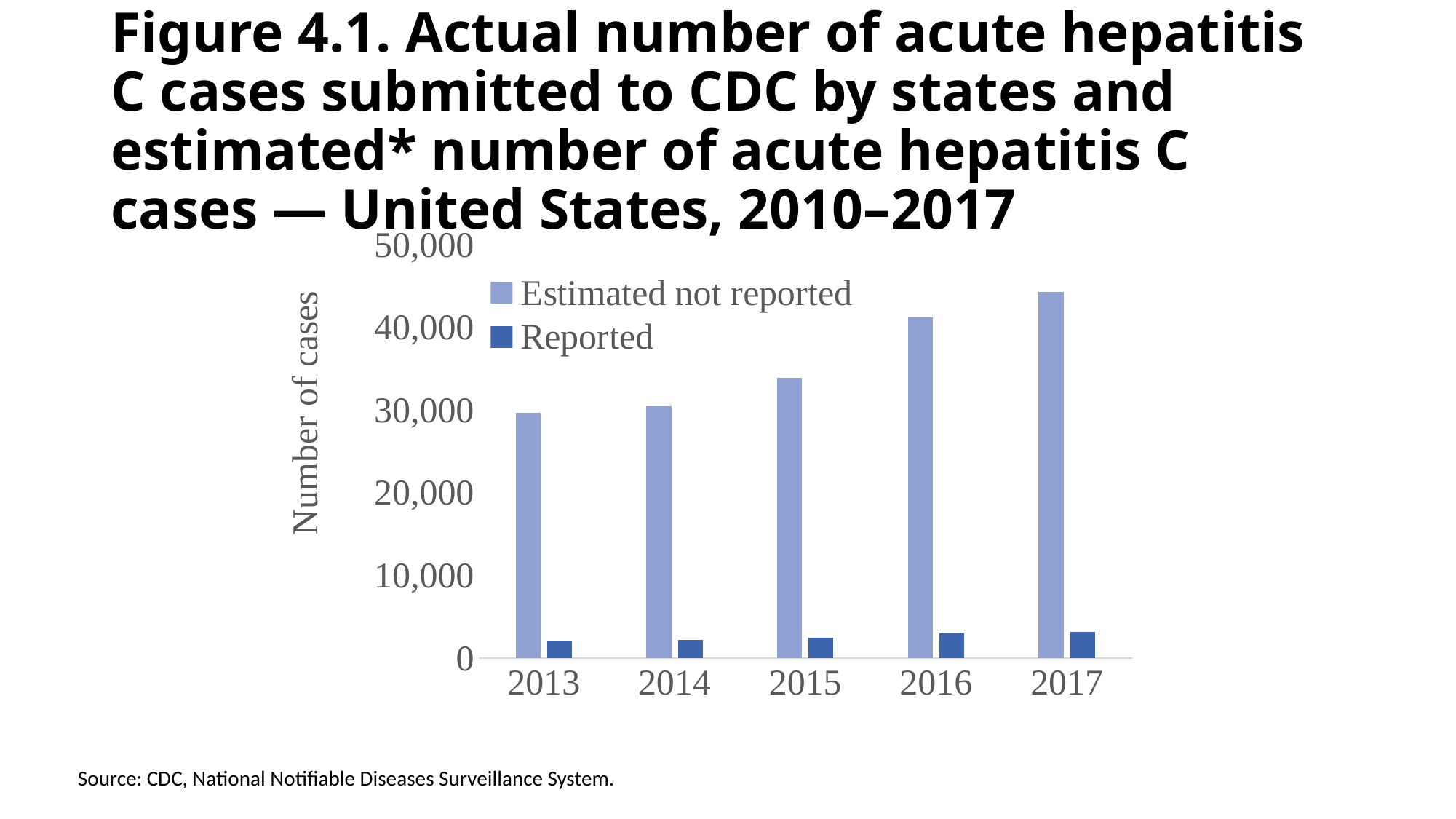
How many years are shown on the x axis? 5 Which year has the highest value for Estimated not reported? 2017 Do the Estimated not reported values rise or fall from 2013 to 2017? rise How many series does the legend list? 2 Is the value for Estimated not reported in 2017 greater or less than 40,000? greater What is the title of the y axis? Number of cases Which is larger, the Estimated not reported value for 2016 or for 2015? 2016 Which year has the highest value for Reported? 2017 Is the value for Estimated not reported in 2015 greater or less than 30,000? greater Is the value for Reported in 2016 greater or less than 10,000? less In 2013, which series has the larger value, Estimated not reported or Reported? Estimated not reported What kind of chart is shown on the slide? bar chart